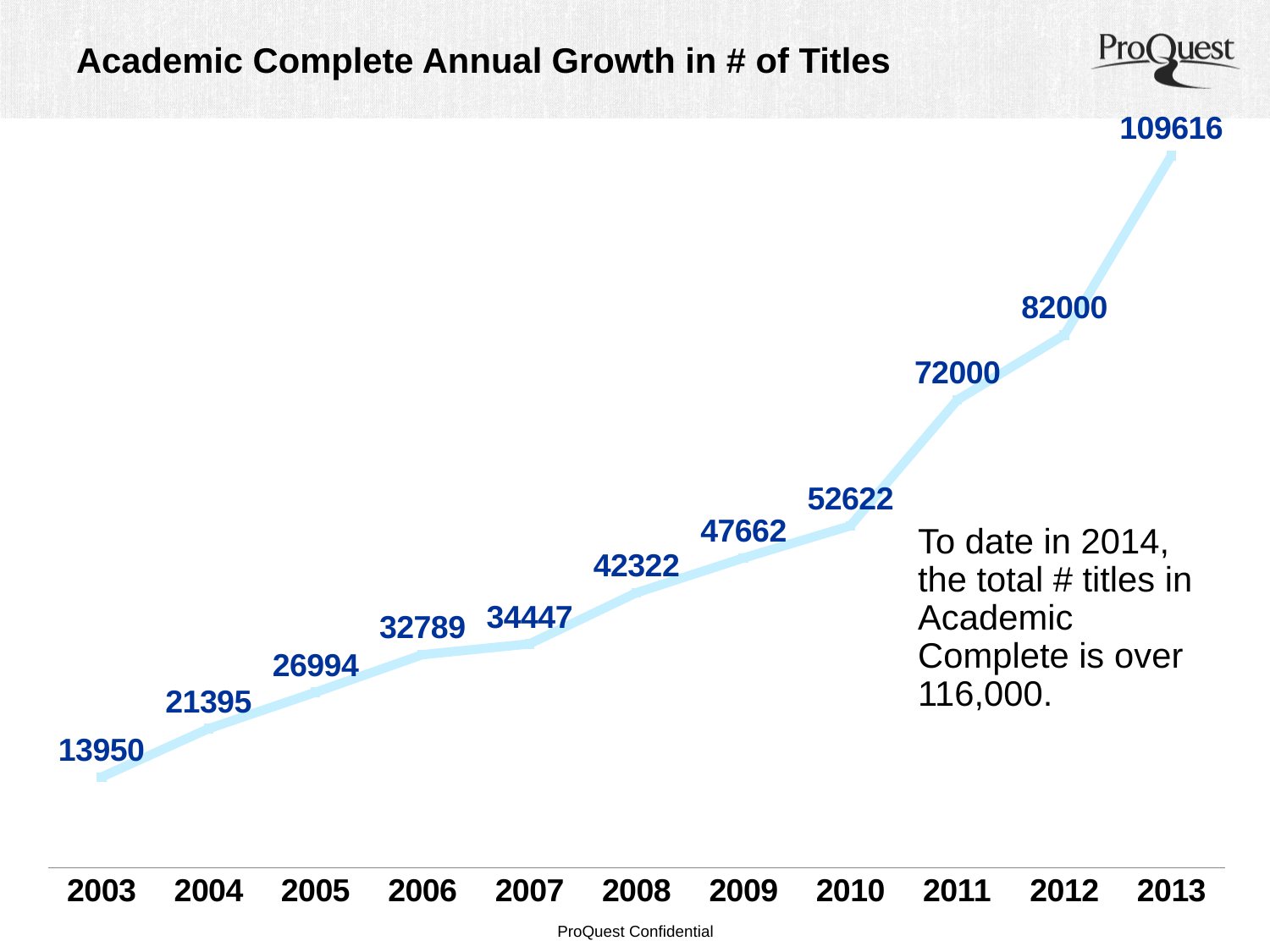
What is the number of titles in 2012? 82000 What is the number of titles in 2008? 42322 Which year has more titles, 2006 or 2007? 2007 What is the difference in number of titles between 2011 and 2010? 19378 What is the number of titles in 2003? 13950 What kind of chart is shown on the slide? line chart What is the difference in number of titles between 2013 and 2012? 27616 How many years are plotted on the chart? 11 Which year has the highest number of titles? 2013 What is the title of the chart? Academic Complete Annual Growth in # of Titles Do the values rise or fall from 2003 to 2013? rise Which year has the lowest number of titles? 2003